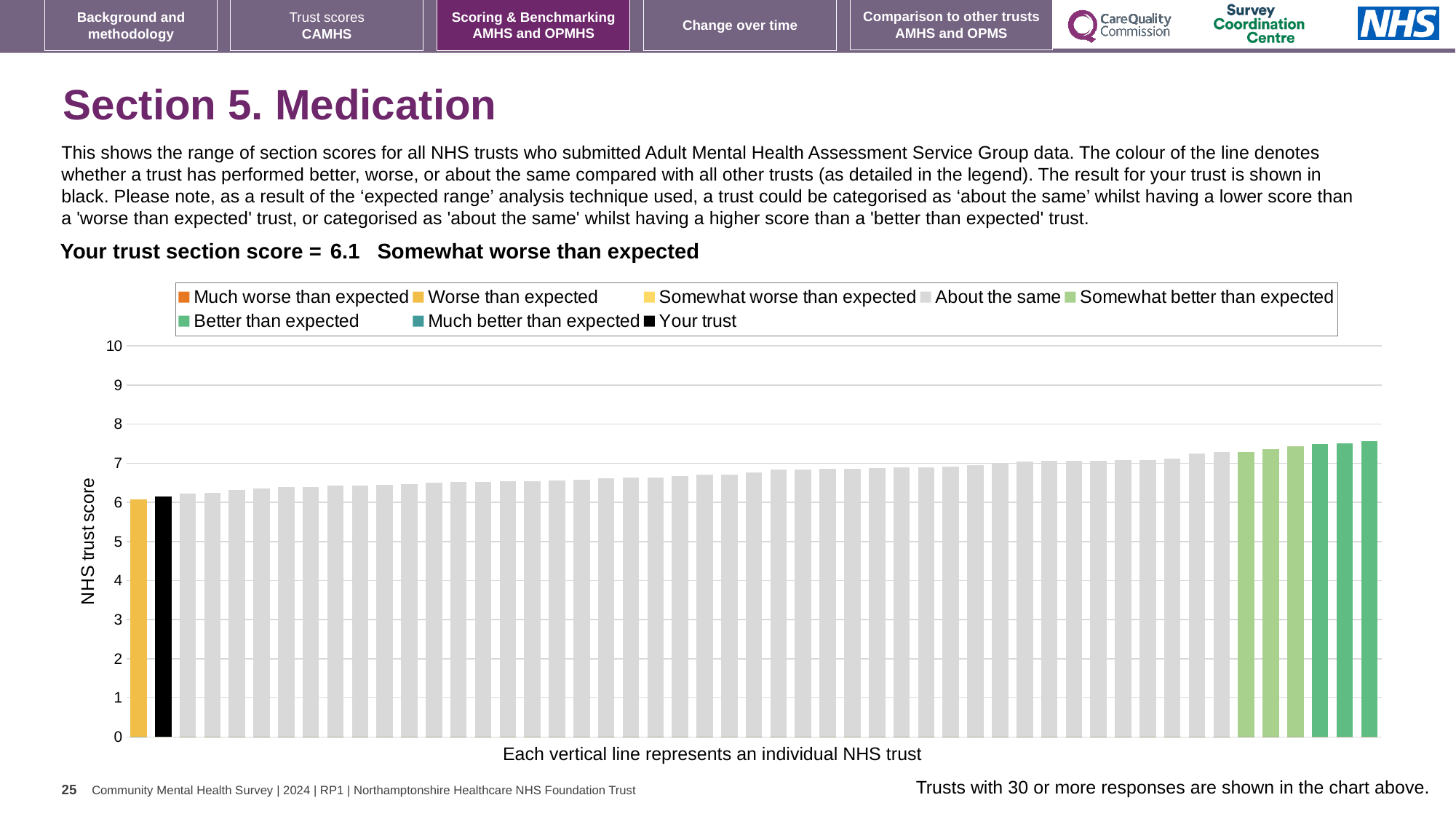
What is the label on the y axis of the chart? NHS trust score What kind of chart is shown on the slide? bar chart Is your trust's bar higher or lower than the rightmost bar? lower Is the value of the tallest bar greater or less than 7? greater What colour is the bar representing your trust? black Is the value for your trust greater or less than 7? less Is the value for your trust greater or less than 5? greater Which category is your trust's section score placed in? Somewhat worse than expected Do the bar values rise or fall from left to right along the x axis? rise What is the section score for your trust? 6.1 How many entries does the chart legend list? 8